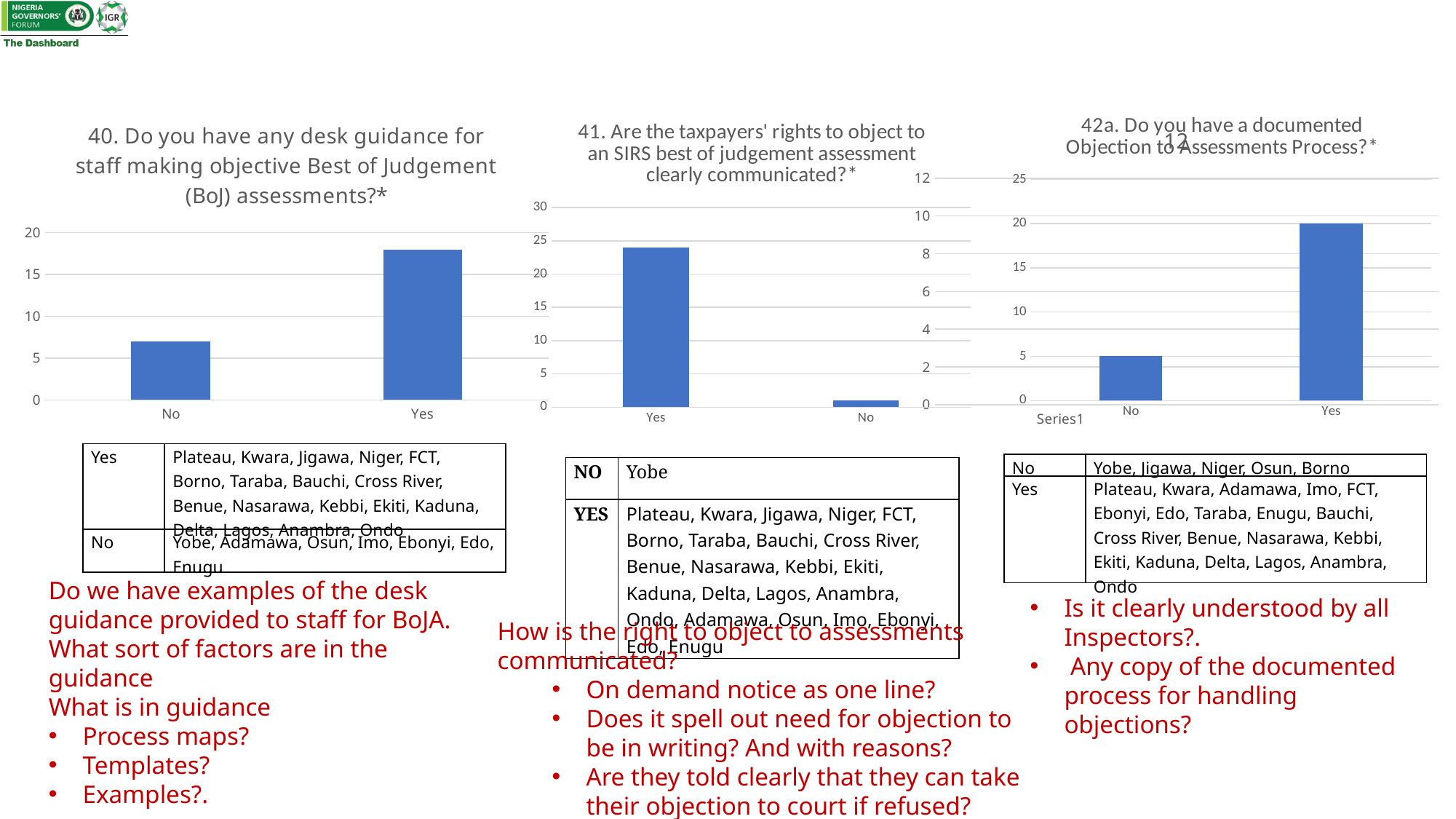
In the chart titled "42a. Do you have a documented Objection to Assessments Process?*", what is the value for No? 5 In the chart titled "41. Are the taxpayers' rights to object to an SIRS best of judgement assessment clearly communicated?*", is the value for No greater or less than 5? less In the chart titled "40. Do you have any desk guidance for staff making objective Best of Judgement (BoJ) assessments?*", is the value for No greater or less than 10? less How many categories are shown on the x axis of the chart titled "40. Do you have any desk guidance for staff making objective Best of Judgement (BoJ) assessments?*"? 2 What kind of chart is the chart titled "42a. Do you have a documented Objection to Assessments Process?*"? Bar chart In the chart titled "42a. Do you have a documented Objection to Assessments Process?*", which is larger, the value for Yes or the value for No? Yes In the chart titled "41. Are the taxpayers' rights to object to an SIRS best of judgement assessment clearly communicated?*", which category has the lowest value? No In the chart titled "42a. Do you have a documented Objection to Assessments Process?*", what is the difference between the Yes and No values? 15 In the chart titled "41. Are the taxpayers' rights to object to an SIRS best of judgement assessment clearly communicated?*", is the value for Yes greater or less than 20? greater In the chart titled "40. Do you have any desk guidance for staff making objective Best of Judgement (BoJ) assessments?*", which category has the highest value? Yes In the chart titled "42a. Do you have a documented Objection to Assessments Process?*", what is the value for Yes? 20